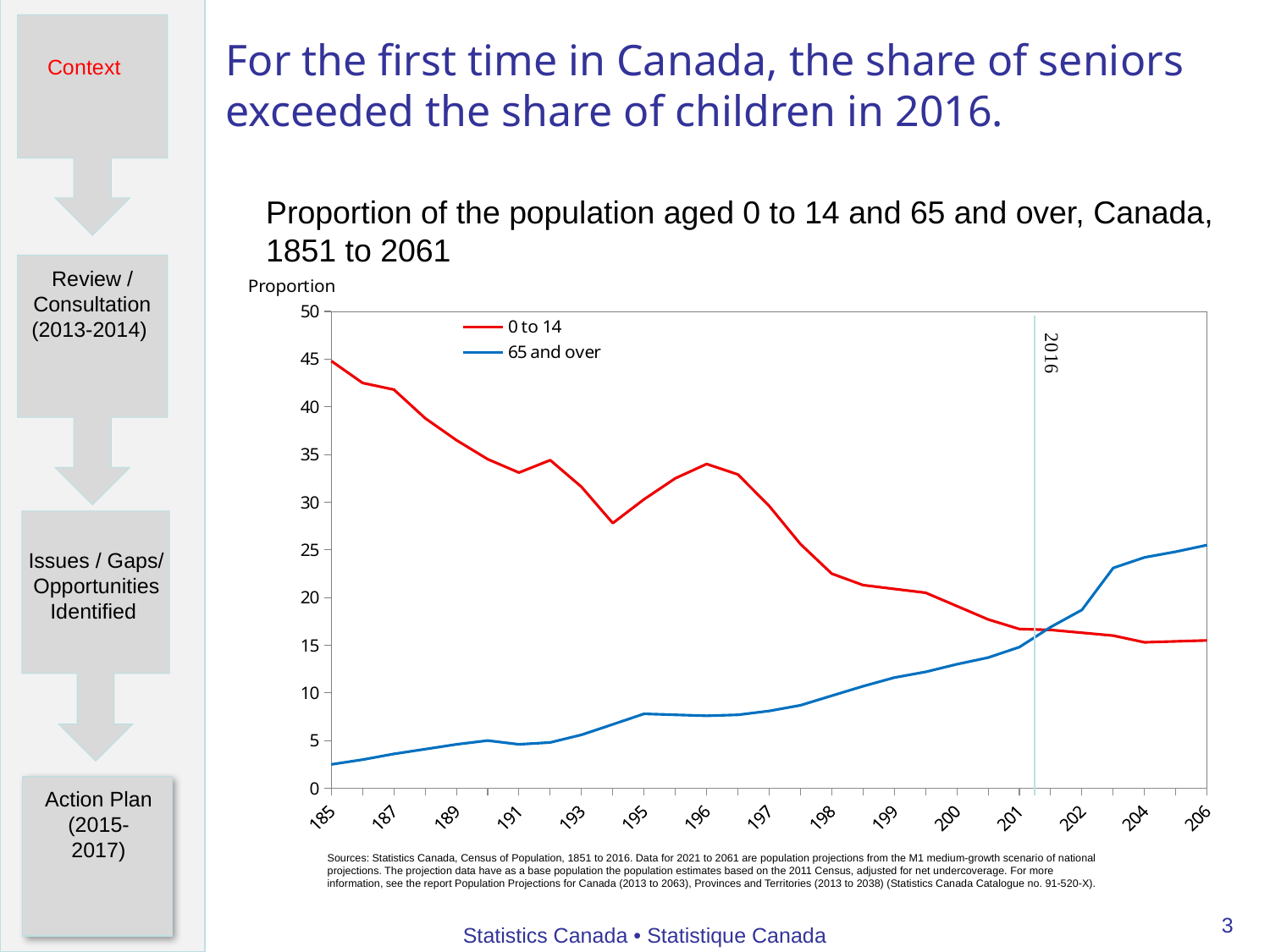
At the left end of the chart, is the value for 0 to 14 greater or less than 40? greater How many series does the chart's legend list? 2 What are the two series named in the chart's legend? 0 to 14 and 65 and over At the right end of the chart, is the value for 65 and over greater or less than 20? greater What year does the vertical line on the chart mark? 2016 What kind of chart is shown on the slide? line chart At the right end of the chart, which series has the higher value, 0 to 14 or 65 and over? 65 and over Does the 65 and over line rise or fall overall from left to right along the x axis? rise At the right end of the chart, is the value for 0 to 14 greater or less than 20? less At the left end of the chart, which series has the higher value, 0 to 14 or 65 and over? 0 to 14 Does the 0 to 14 line rise or fall overall from left to right along the x axis? fall